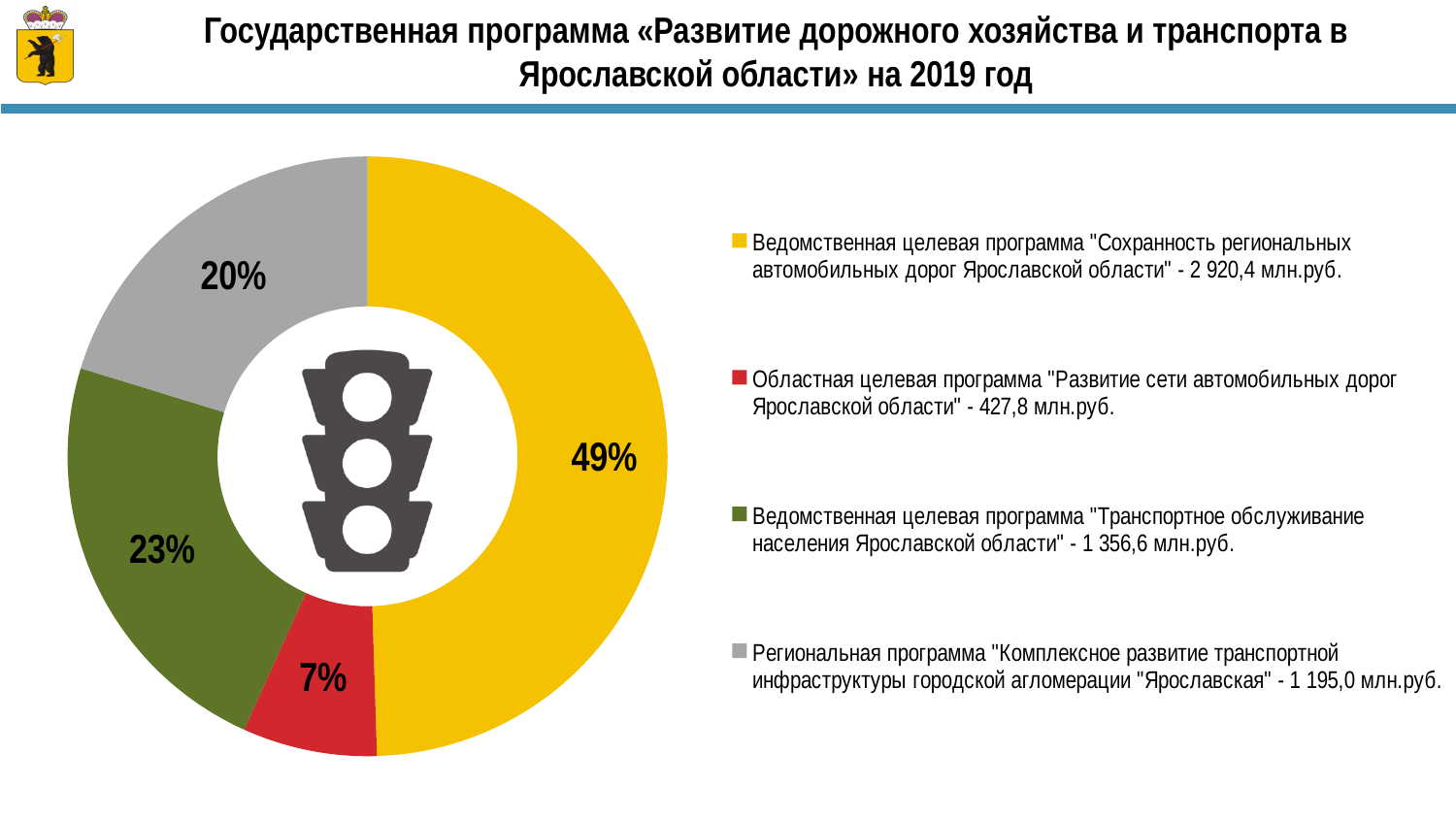
What share of the chart does the green slice (Ведомственная целевая программа "Транспортное обслуживание населения Ярославской области") represent? 23% How many slices does the doughnut chart have? 4 Which programme has the largest share of the chart? Ведомственная целевая программа "Сохранность региональных автомобильных дорог Ярославской области" (49%) According to the legend, what is the funding amount for the programme "Транспортное обслуживание населения Ярославской области"? 1 356,6 млн.руб. What share of the chart does the yellow slice (Ведомственная целевая программа "Сохранность региональных автомобильных дорог Ярославской области") represent? 49% According to the legend, what is the funding amount for the programme "Сохранность региональных автомобильных дорог Ярославской области"? 2 920,4 млн.руб. What share of the chart does the red slice (Областная целевая программа "Развитие сети автомобильных дорог Ярославской области") represent? 7% What is the difference in percentage points between the largest slice (49%) and the smallest slice (7%)? 42 percentage points Which slice is larger: the green slice (Транспортное обслуживание населения) or the grey slice (Комплексное развитие транспортной инфраструктуры)? The green slice (23%) What kind of chart is shown on the slide? Doughnut (pie) chart Which programme has the smallest share of the chart? Областная целевая программа "Развитие сети автомобильных дорог Ярославской области" (7%)